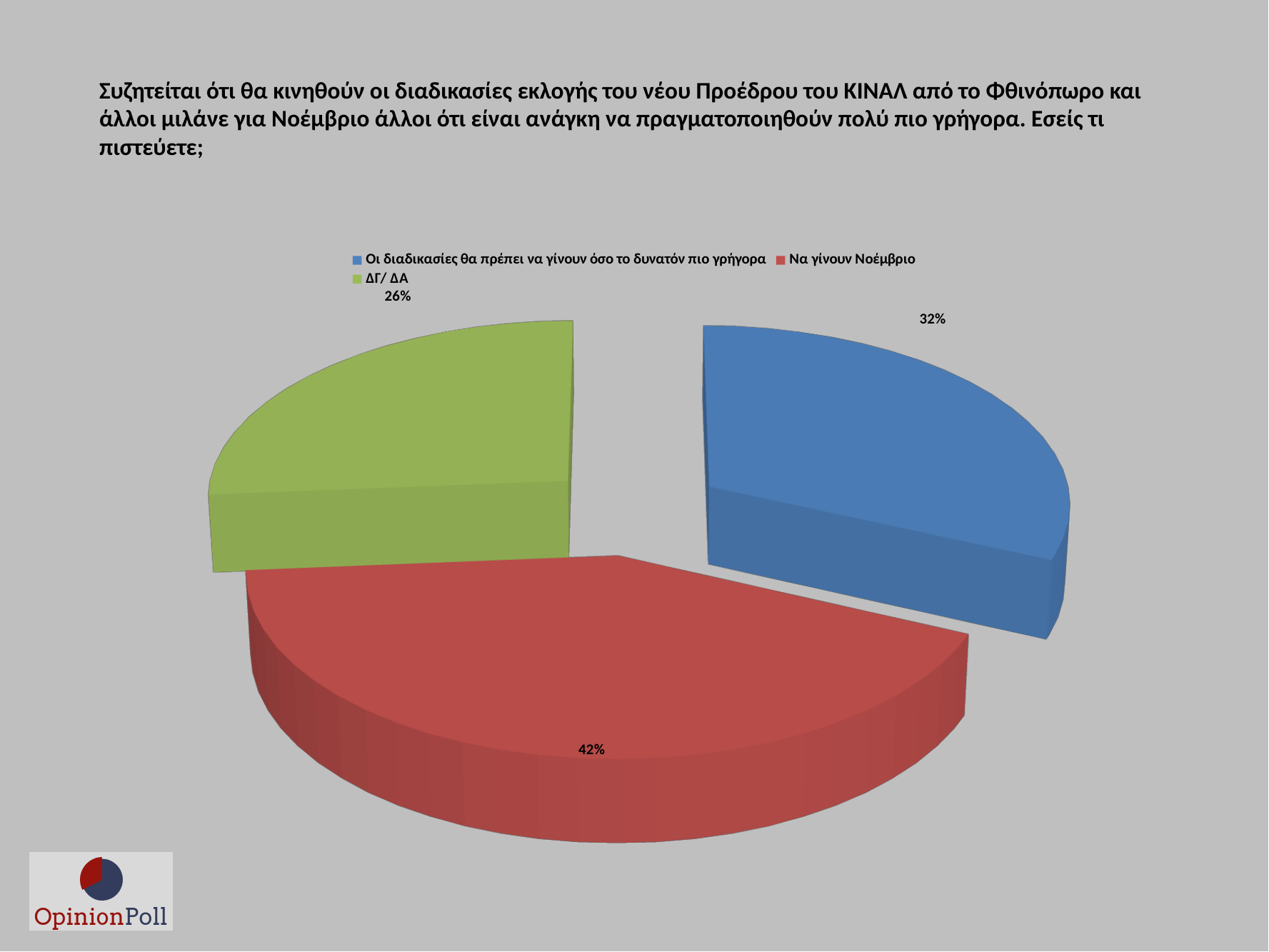
What is the difference in percentage points between "Οι διαδικασίες θα πρέπει να γίνουν όσο το δυνατόν πιο γρήγορα" and "ΔΓ/ ΔΑ"? 6 percentage points What percentage of respondents answered "Να γίνουν Νοέμβριο"? 42% Which is larger: the share for "Να γίνουν Νοέμβριο" or the share for "ΔΓ/ ΔΑ"? Να γίνουν Νοέμβριο Which response has the largest share of the pie? Να γίνουν Νοέμβριο How many slices does the pie chart have? 3 Which response has the smallest share of the pie? ΔΓ/ ΔΑ What percentage of respondents answered "Οι διαδικασίες θα πρέπει να γίνουν όσο το δυνατόν πιο γρήγορα"? 32% What kind of chart is shown on the slide? Pie chart What is the difference in percentage points between "Να γίνουν Νοέμβριο" and "Οι διαδικασίες θα πρέπει να γίνουν όσο το δυνατόν πιο γρήγορα"? 10 percentage points What colour is the slice for "Να γίνουν Νοέμβριο"? Red What percentage of respondents answered "ΔΓ/ ΔΑ"? 26% What colour is the slice for "ΔΓ/ ΔΑ"? Green